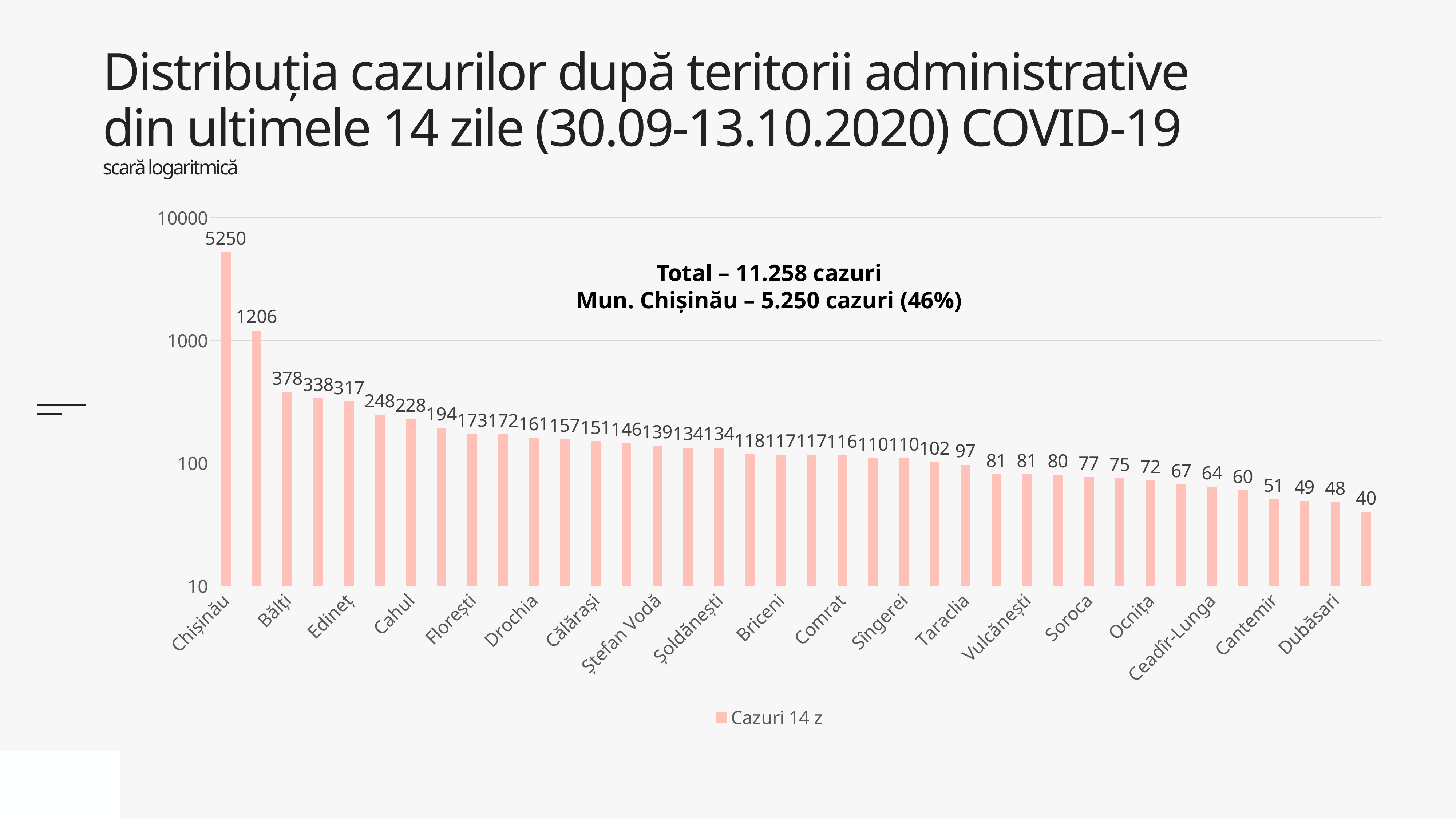
Do the values rise or fall moving from left to right along the x axis? fall How many bars are plotted in the chart? 38 What is the value shown for Chișinău? 5250 How many series does the legend list? 1 What kind of scale is used on the vertical axis, according to the subtitle? scară logaritmică Is the value for Dubăsari greater or less than 100? less What is the difference between the highest bar (5250) and the second-highest bar (1206)? 4044 What is the name of the series in the legend? Cazuri 14 z What is the lowest value shown on any bar in the chart? 40 According to the text on the chart, what share of the total cases does Mun. Chișinău account for? 46% Which territory has the highest number of cases in the chart? Chișinău What type of chart is shown on the slide? bar chart